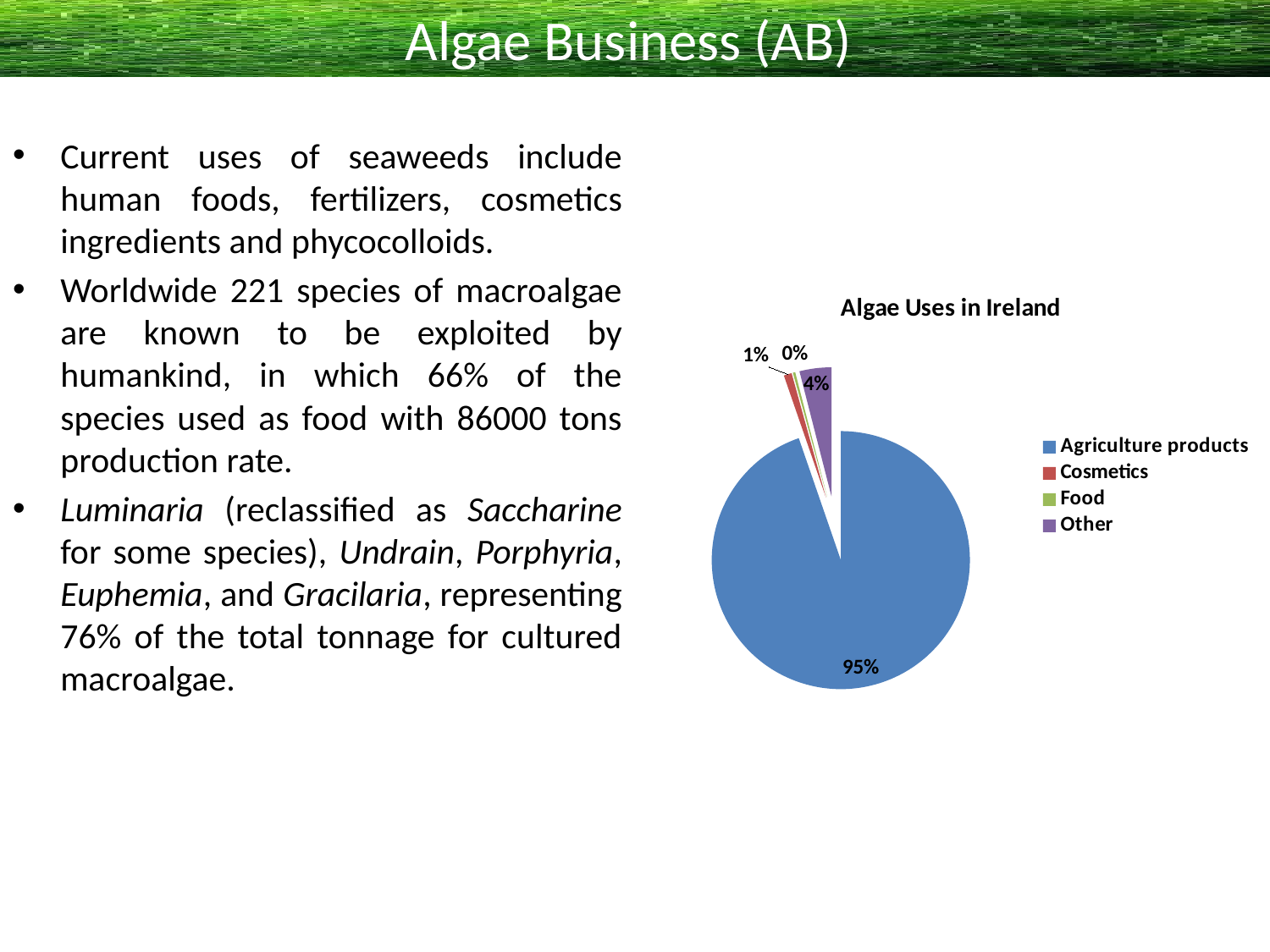
What share of the pie is Food? 0% How many categories does the legend list? 4 Which is larger, the share for Other or the share for Cosmetics? Other What share of the pie is Cosmetics? 1% What is the difference between the share for Agriculture products and the share for Other? 91% What share of the pie is Agriculture products? 95% What colour is the Agriculture products slice? blue What kind of chart is shown on the slide? pie chart What is the title of the chart? Algae Uses in Ireland Which category has the largest slice of the pie? Agriculture products Which category has the smallest slice of the pie? Food